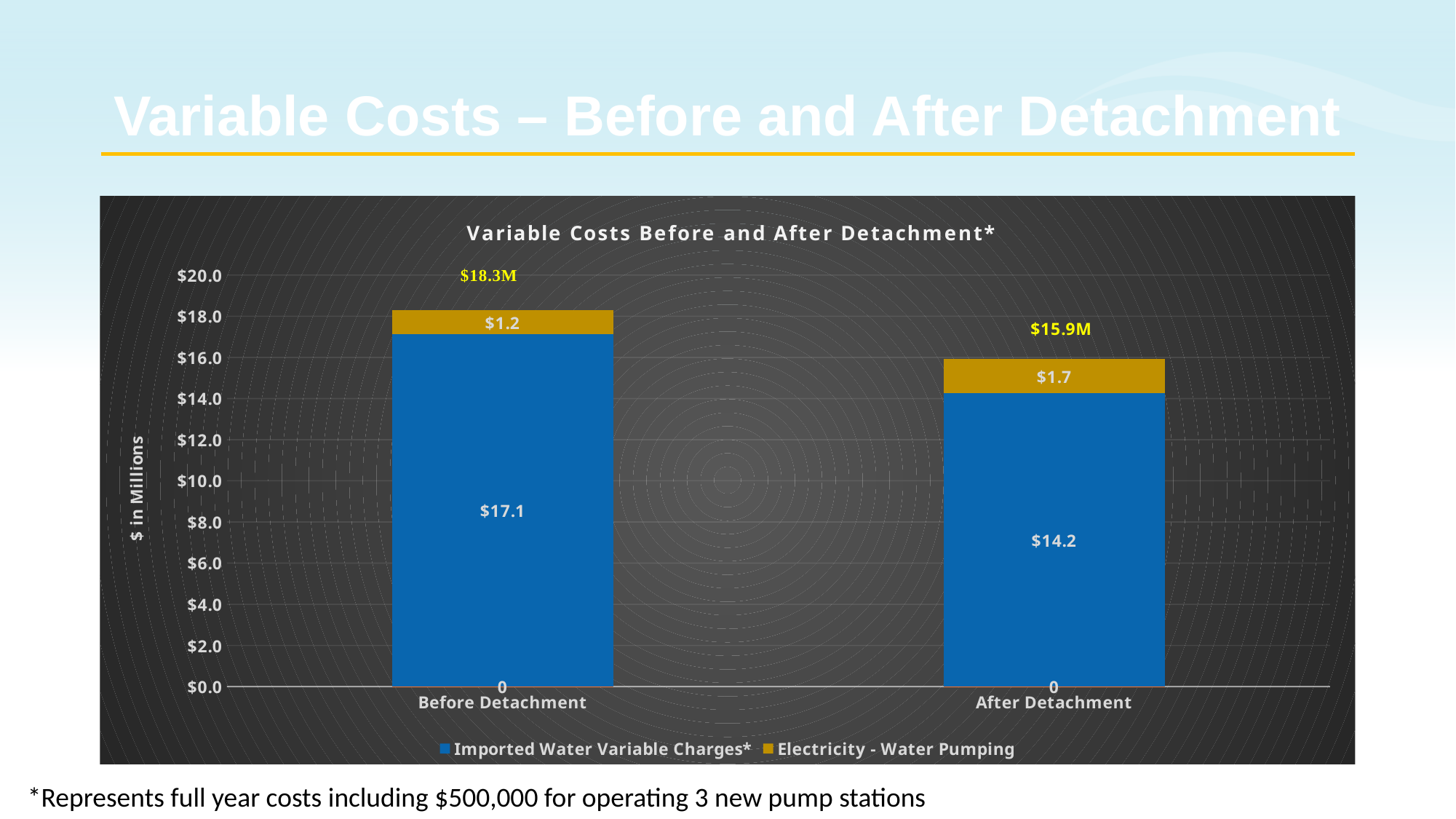
What is the total of the stacked bar for After Detachment? $15.9M What is the value of Electricity - Water Pumping for After Detachment? $1.7 What is the value of Electricity - Water Pumping for Before Detachment? $1.2 What is the value of Imported Water Variable Charges* for Before Detachment? $17.1 What is the difference in Electricity - Water Pumping between After Detachment and Before Detachment? $0.5 What type of chart is shown on the slide? Stacked bar chart How many series does the legend list? 2 What is the value of Imported Water Variable Charges* for After Detachment? $14.2 What is the total of the stacked bar for Before Detachment? $18.3M What is the difference in Imported Water Variable Charges* between Before Detachment and After Detachment? $2.9 Which category has the higher Imported Water Variable Charges* value, Before Detachment or After Detachment? Before Detachment How many categories are shown on the x axis? 2